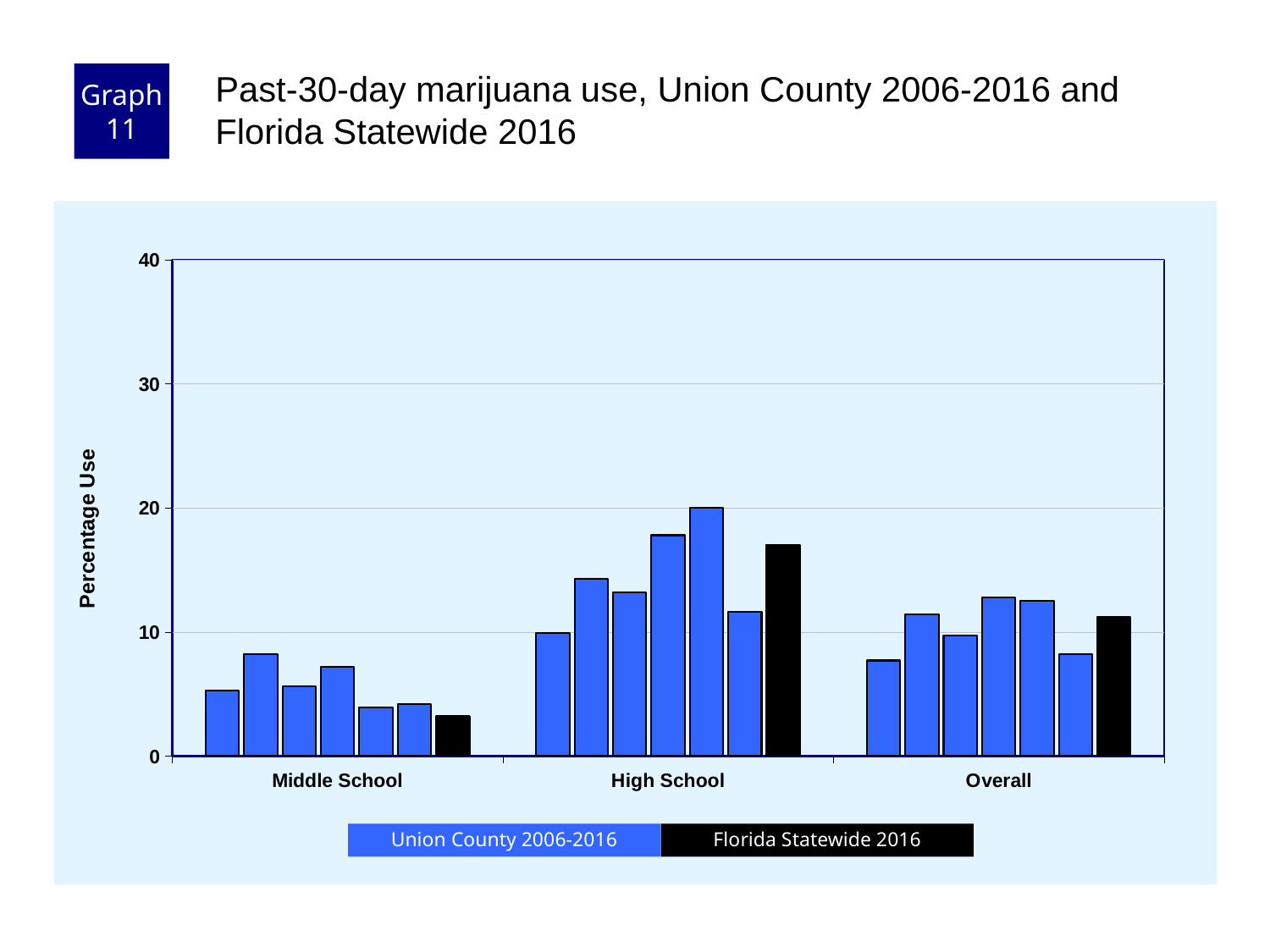
Is the Florida Statewide 2016 value for Middle School greater or less than 10? less Which is larger, the Florida Statewide 2016 value for High School or for Overall? High School How many series does the legend list? 2 For which category is the Florida Statewide 2016 bar the highest? High School Is the Florida Statewide 2016 value for High School greater or less than 10? greater What is the label on the y axis? Percentage Use How many categories are shown along the x axis? 3 What kind of chart is shown on the slide? bar chart Are all of the Union County 2006-2016 bars for Middle School greater or less than 10? less For which category is the Florida Statewide 2016 bar the lowest? Middle School What colour are the Florida Statewide 2016 bars? black